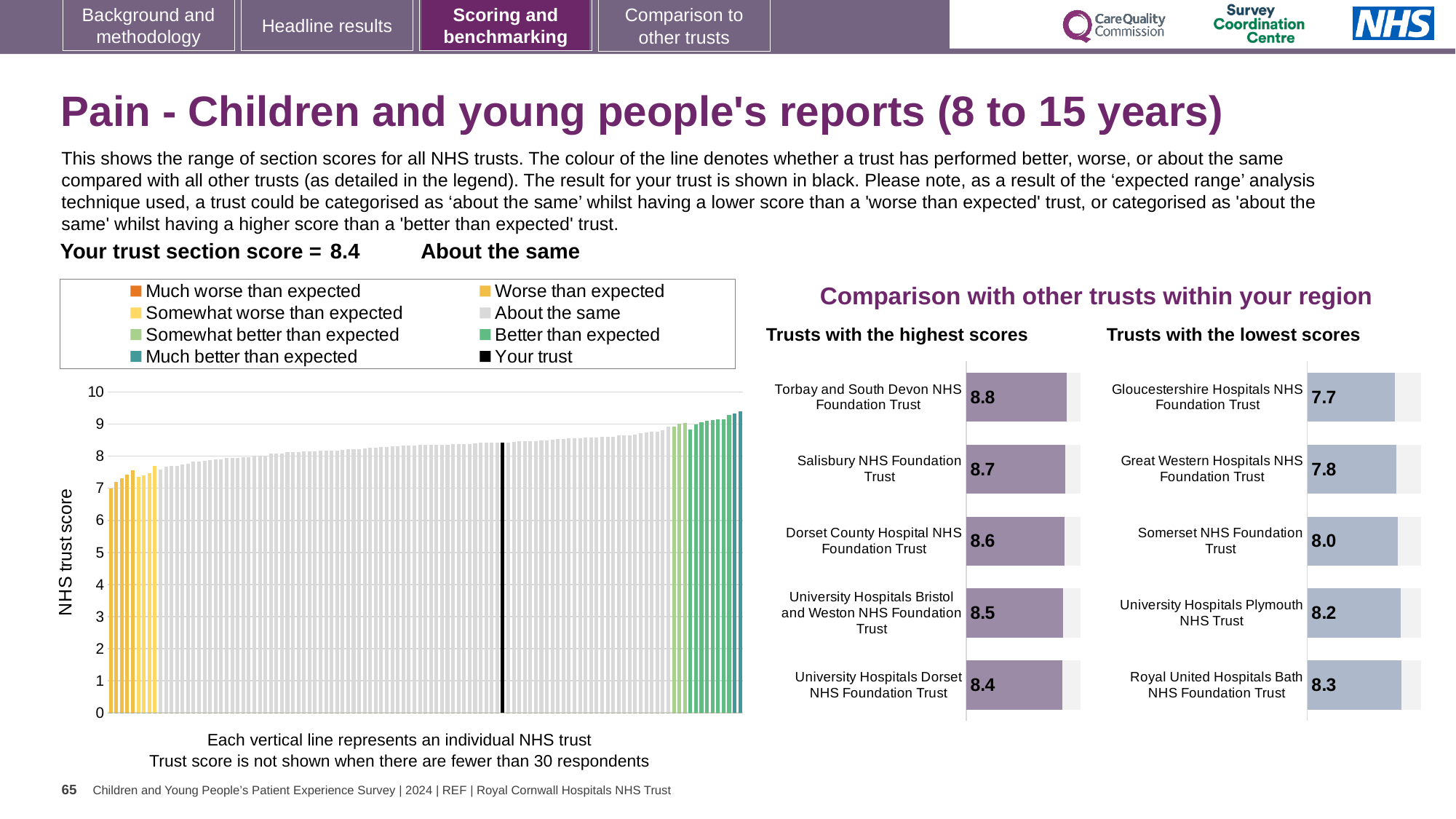
In the NHS trust score chart on the left, is the value of the black bar (your trust) greater or less than 8? greater In the 'Trusts with the highest scores' chart, what is the difference between the scores of Torbay and South Devon NHS Foundation Trust and University Hospitals Dorset NHS Foundation Trust? 0.4 In the 'Trusts with the lowest scores' chart, which trust has the lowest score? Gloucestershire Hospitals NHS Foundation Trust In the 'Trusts with the lowest scores' chart, what is the score for Somerset NHS Foundation Trust? 8.0 In the 'Trusts with the highest scores' chart, what is the score for Dorset County Hospital NHS Foundation Trust? 8.6 What kind of chart is the NHS trust score chart on the left? bar chart In the 'Trusts with the highest scores' chart, which trust has the highest score? Torbay and South Devon NHS Foundation Trust In the 'Trusts with the lowest scores' chart, which has the higher score: Great Western Hospitals NHS Foundation Trust or University Hospitals Plymouth NHS Trust? University Hospitals Plymouth NHS Trust How many trusts are shown in the 'Trusts with the highest scores' chart? 5 In the 'Trusts with the highest scores' chart, what is the score for Torbay and South Devon NHS Foundation Trust? 8.8 How many entries does the legend of the NHS trust score chart on the left list? 8 In the 'Trusts with the lowest scores' chart, what is the difference between the scores of Royal United Hospitals Bath NHS Foundation Trust and Gloucestershire Hospitals NHS Foundation Trust? 0.6